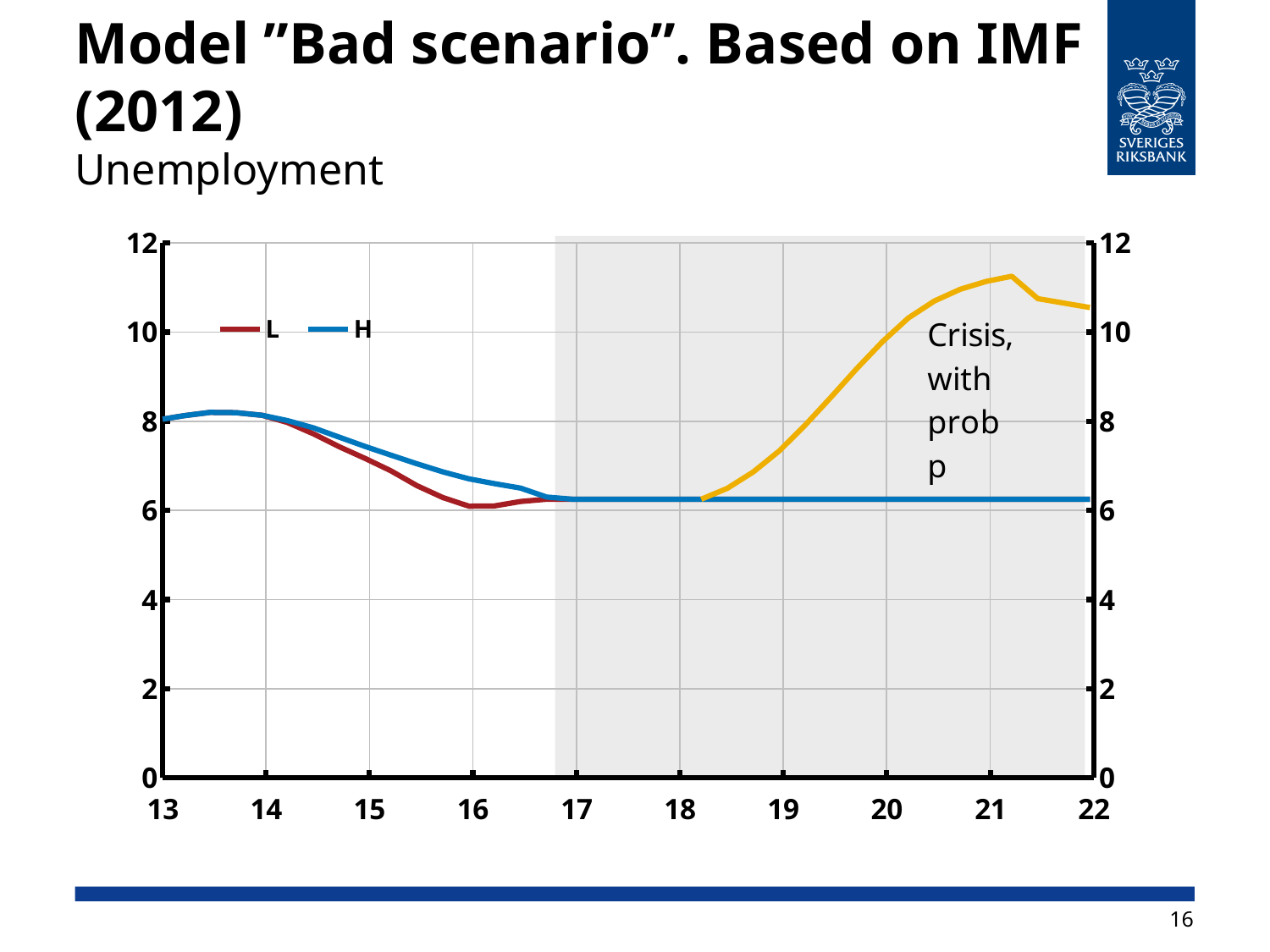
What is the subtitle of the chart below the slide title? Unemployment How many series does the chart's legend list? 2 Is the value of the L series at 16 greater or less than 8? less Is the value of the H series at 20 greater or less than 8? less Is the value of the yellow crisis line at 21 greater or less than 10? greater How many year labels are shown on the x axis? 10 What are the two series named in the legend? L and H At 16, which series has the higher value, L or H? H What kind of chart is shown on the slide? line chart Does the yellow crisis line rise or fall between 18 and 21? rise Does the L series rise or fall between 14 and 16? fall